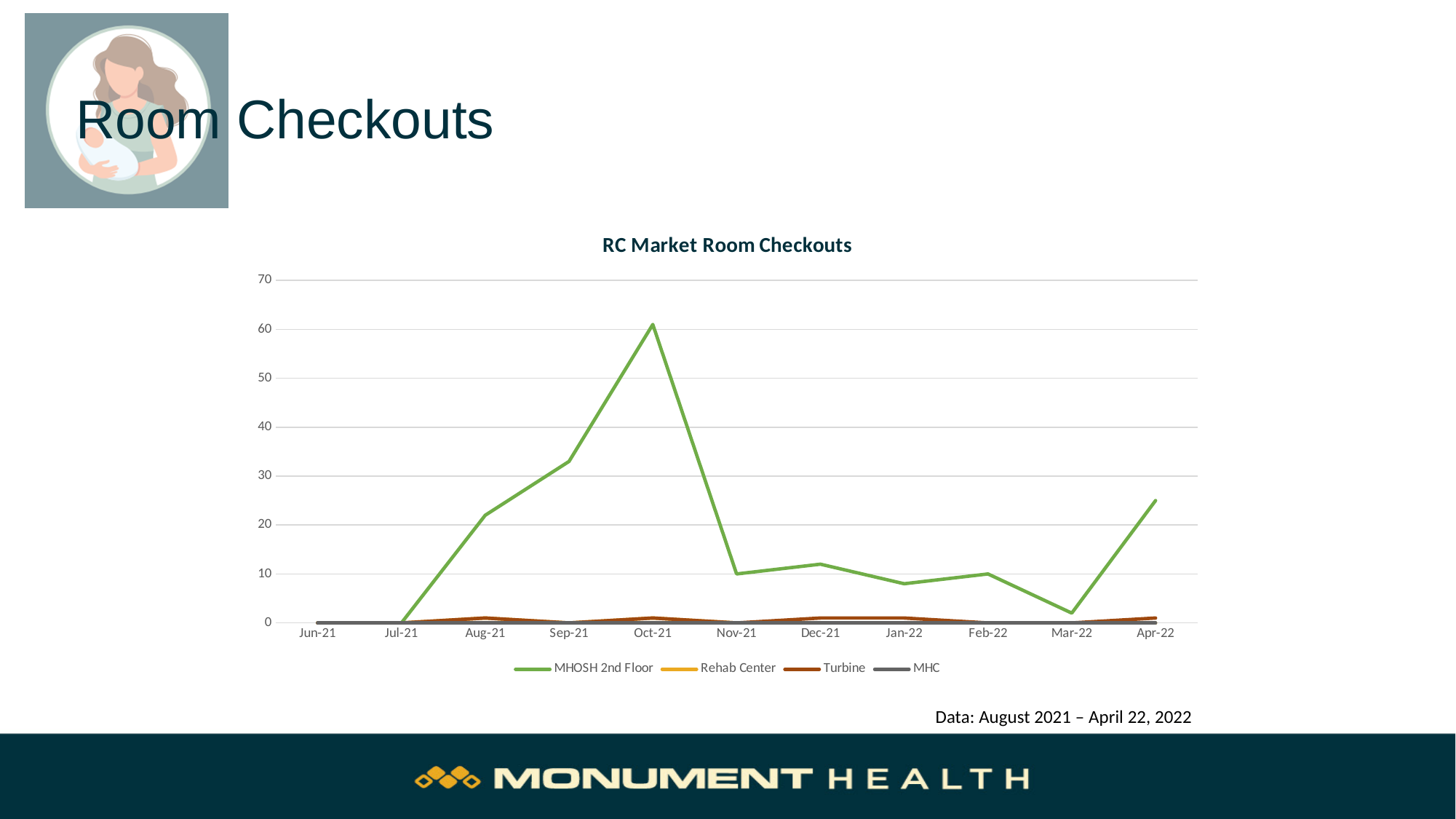
Which series is drawn in green? MHOSH 2nd Floor Is the value for MHOSH 2nd Floor in Sep-21 greater or less than 30? greater What type of chart is shown on the slide? line chart Does the MHOSH 2nd Floor series rise or fall between Oct-21 and Nov-21? fall How many series does the legend list? 4 In which month does the MHOSH 2nd Floor series reach its highest value? Oct-21 Is the value for MHOSH 2nd Floor in Mar-22 greater or less than 10? less Which is larger for MHOSH 2nd Floor: the value in Aug-21 or the value in Dec-21? Aug-21 Is the value for MHOSH 2nd Floor in Apr-22 greater or less than 20? greater What is the title of the chart? RC Market Room Checkouts How many months are shown on the x axis? 11